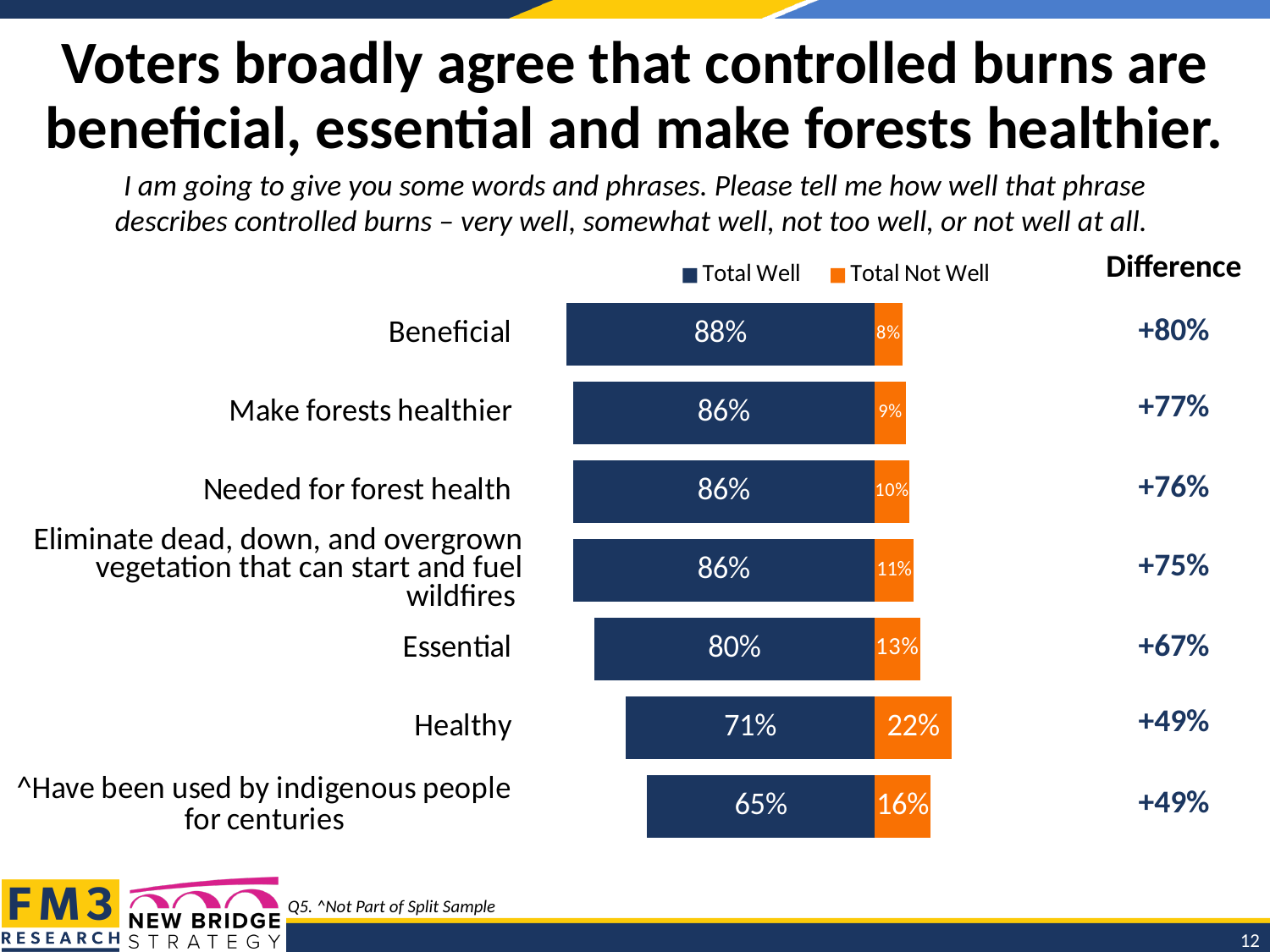
What is the Total Well value for "Essential"? 80% What is the difference between the Total Well and Total Not Well values for "Essential"? +67% Which category has the lowest Total Well value? Have been used by indigenous people for centuries What is the Total Not Well value for "Healthy"? 22% How many series does the legend list? 2 Which category has the highest Total Well value? Beneficial How many categories are shown in the chart? 7 Which is larger: the Total Well value for "Healthy" or for "Essential"? Essential What is the Total Well value for "Beneficial"? 88% What is the Total Not Well value for "Have been used by indigenous people for centuries"? 16% What kind of chart is shown on the slide? Bar chart Which category has the highest Total Not Well value? Healthy